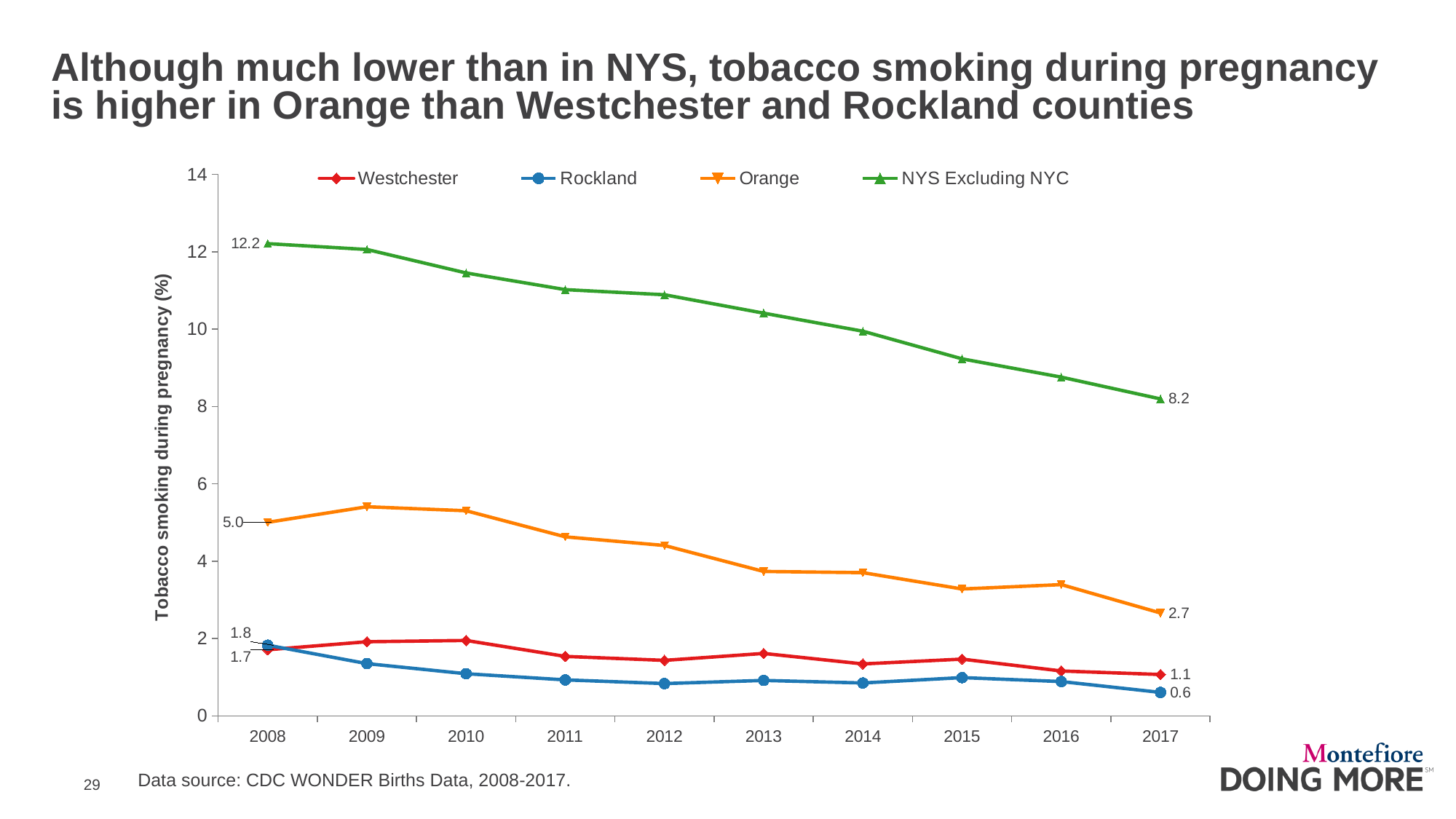
By how much did the NYS Excluding NYC rate fall from 2008 to 2017? 4.0 Is the value for Orange in 2009 greater or less than 4? greater What type of chart is shown on the slide? line chart What was the tobacco smoking during pregnancy rate for NYS Excluding NYC in 2008? 12.2 How many series does the legend list? 4 What was the value for Rockland in 2017? 0.6 How many years are shown on the x axis? 10 Which series had the highest value in 2017? NYS Excluding NYC Which series had the lowest value in 2017? Rockland What was the value for Westchester in 2008? 1.7 What was the value for Orange in 2017? 2.7 Does the NYS Excluding NYC line rise or fall from 2008 to 2017? fall